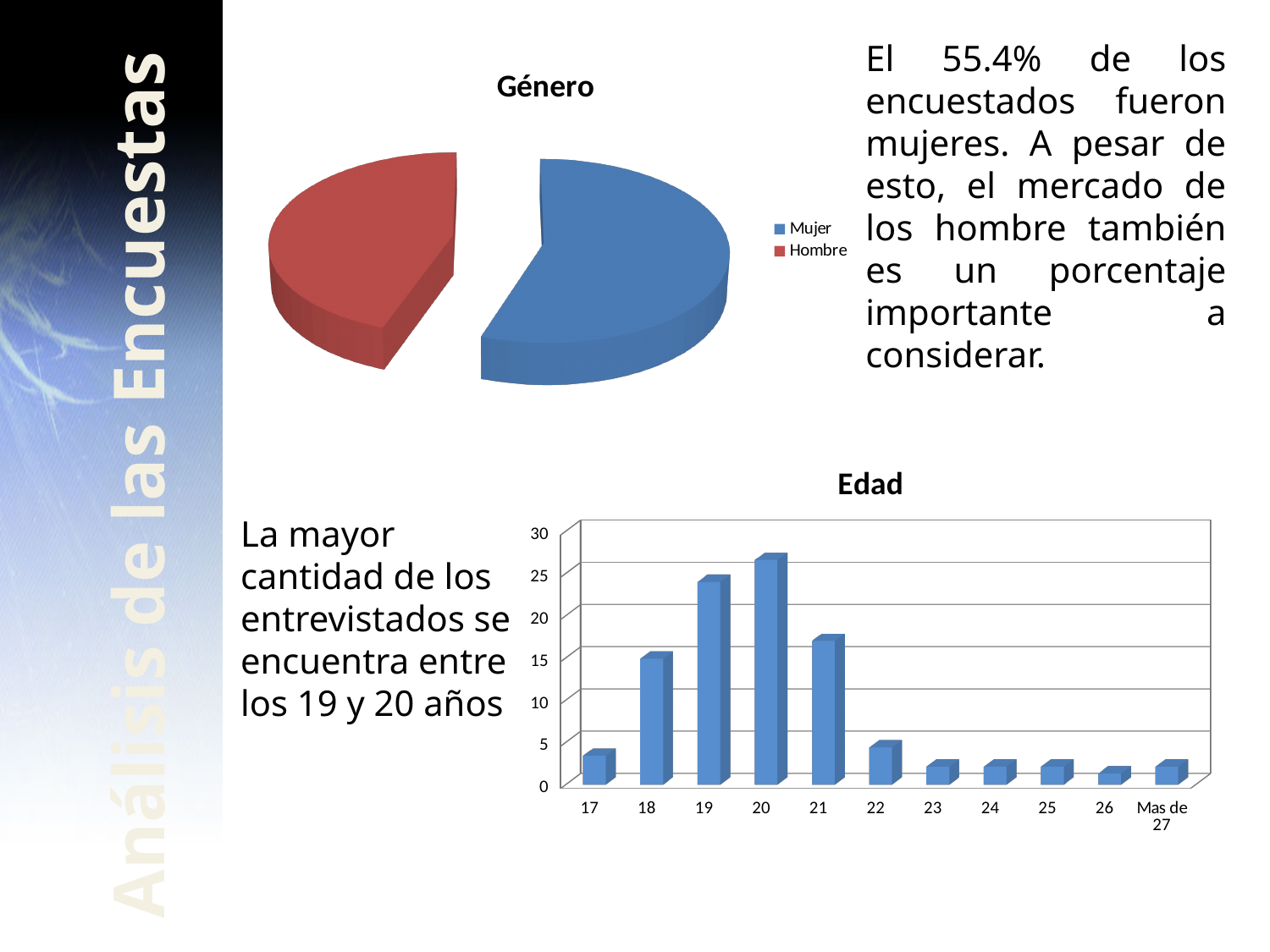
In the 'Género' pie chart, how many entries does the legend list? 2 In the 'Género' pie chart, what colour is the Hombre slice? red In the 'Edad' bar chart, do the values rise or fall from age 20 to age 23? fall In the 'Edad' bar chart, is the value for age 18 greater or less than 20? less What type of chart is the 'Género' chart? pie chart In the 'Género' pie chart, which slice is larger, Mujer or Hombre? Mujer What type of chart is the 'Edad' chart? bar chart In the 'Edad' bar chart, how many age categories are shown on the x axis? 11 In the 'Edad' bar chart, is the value for age 20 greater or less than 25? greater In the 'Edad' bar chart, which age category has the highest bar? 20 In the 'Edad' bar chart, is the value for age 17 greater or less than 5? less In the 'Edad' bar chart, which is larger, the value for age 19 or the value for age 21? 19